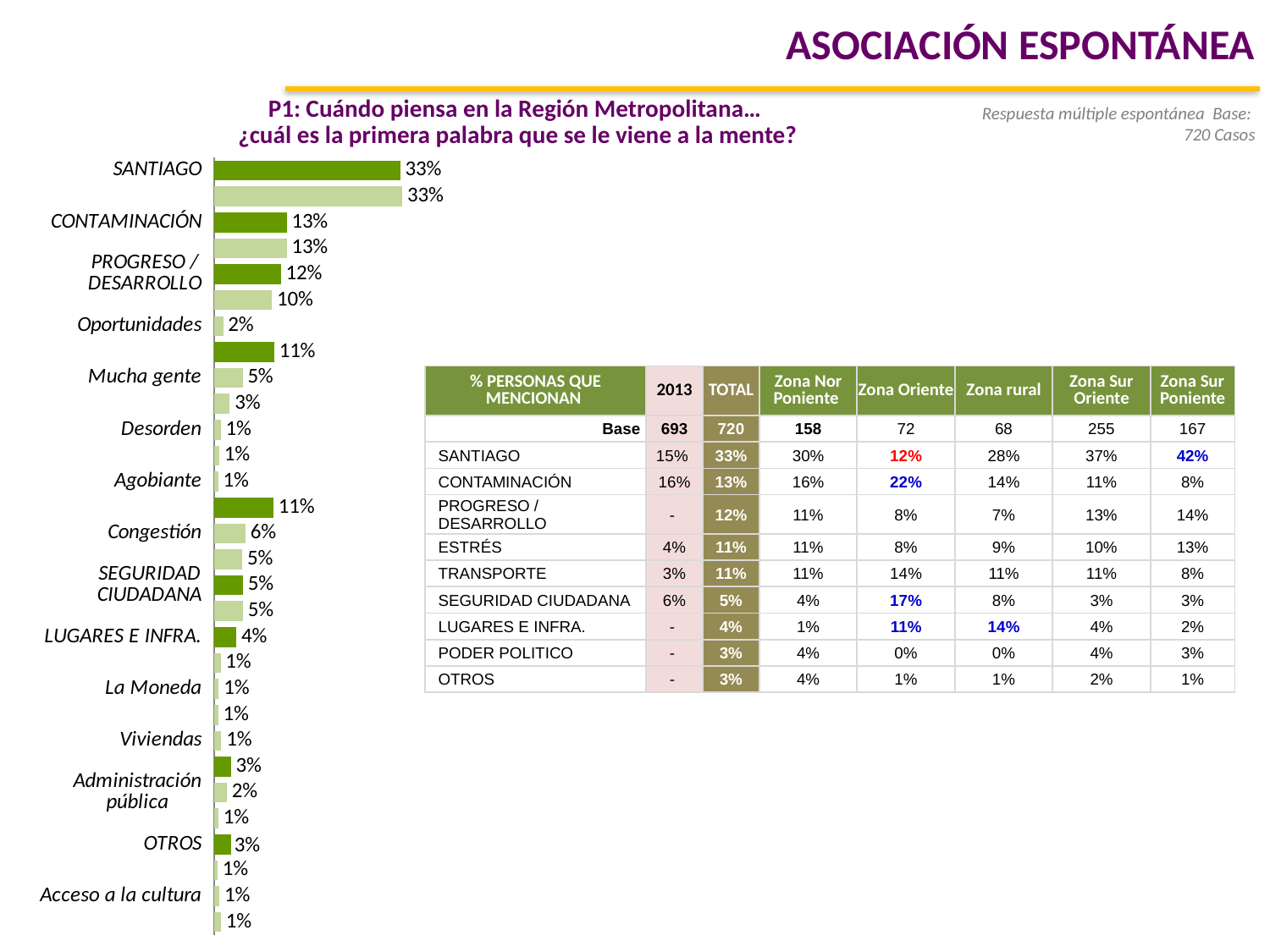
What value is shown for CONTAMINACIÓN in the bar chart? 13% Which category has the highest value in the bar chart? SANTIAGO What value is shown for Congestión in the bar chart? 6% What is the difference between the values for SANTIAGO and CONTAMINACIÓN in the bar chart? 20% What kind of chart is shown on the left of the slide? Bar chart What value is shown for Oportunidades in the bar chart? 2% What question is the bar chart titled with? P1: Cuándo piensa en la Región Metropolitana… ¿cuál es la primera palabra que se le viene a la mente? What value is shown for SANTIAGO in the bar chart? 33% What is the difference between the values for CONTAMINACIÓN and PROGRESO / DESARROLLO in the bar chart? 1% What value is shown for LUGARES E INFRA. in the bar chart? 4% Which is larger in the bar chart, the value for SANTIAGO or the value for CONTAMINACIÓN? SANTIAGO What value is shown for PROGRESO / DESARROLLO in the bar chart? 12%